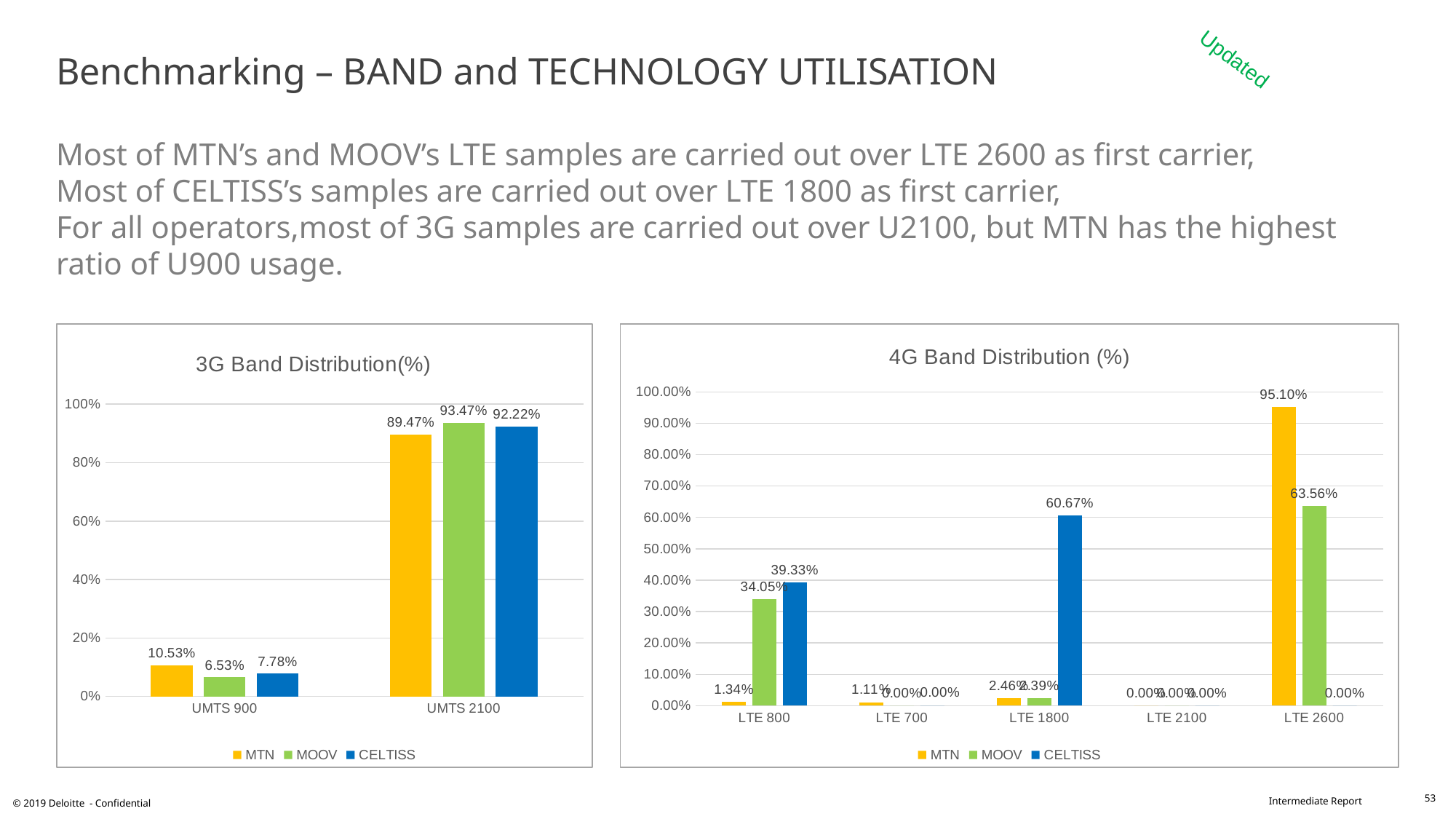
In the 4G Band Distribution (%) chart, what is the difference between MTN and MOOV at LTE 2600? 31.54% In the 4G Band Distribution (%) chart, which band has the highest value for MTN? LTE 2600 In the 3G Band Distribution(%) chart, which operator has the highest value at UMTS 2100? MOOV In the 3G Band Distribution(%) chart, what is the value for MTN at UMTS 900? 10.53% In the 3G Band Distribution(%) chart, what is the difference between MTN and MOOV at UMTS 900? 4.00% In the 4G Band Distribution (%) chart, what is the value for CELTISS at LTE 1800? 60.67% In the 4G Band Distribution (%) chart, how many band categories are shown on the x axis? 5 In the 4G Band Distribution (%) chart, what is the value for MOOV at LTE 800? 34.05% In the 3G Band Distribution(%) chart, what is the value for MOOV at UMTS 2100? 93.47% In the 4G Band Distribution (%) chart, which is larger at LTE 2600: MTN or MOOV? MTN In the 3G Band Distribution(%) chart, how many series does the legend list? 3 What type of chart is the 4G Band Distribution (%) chart? Bar chart